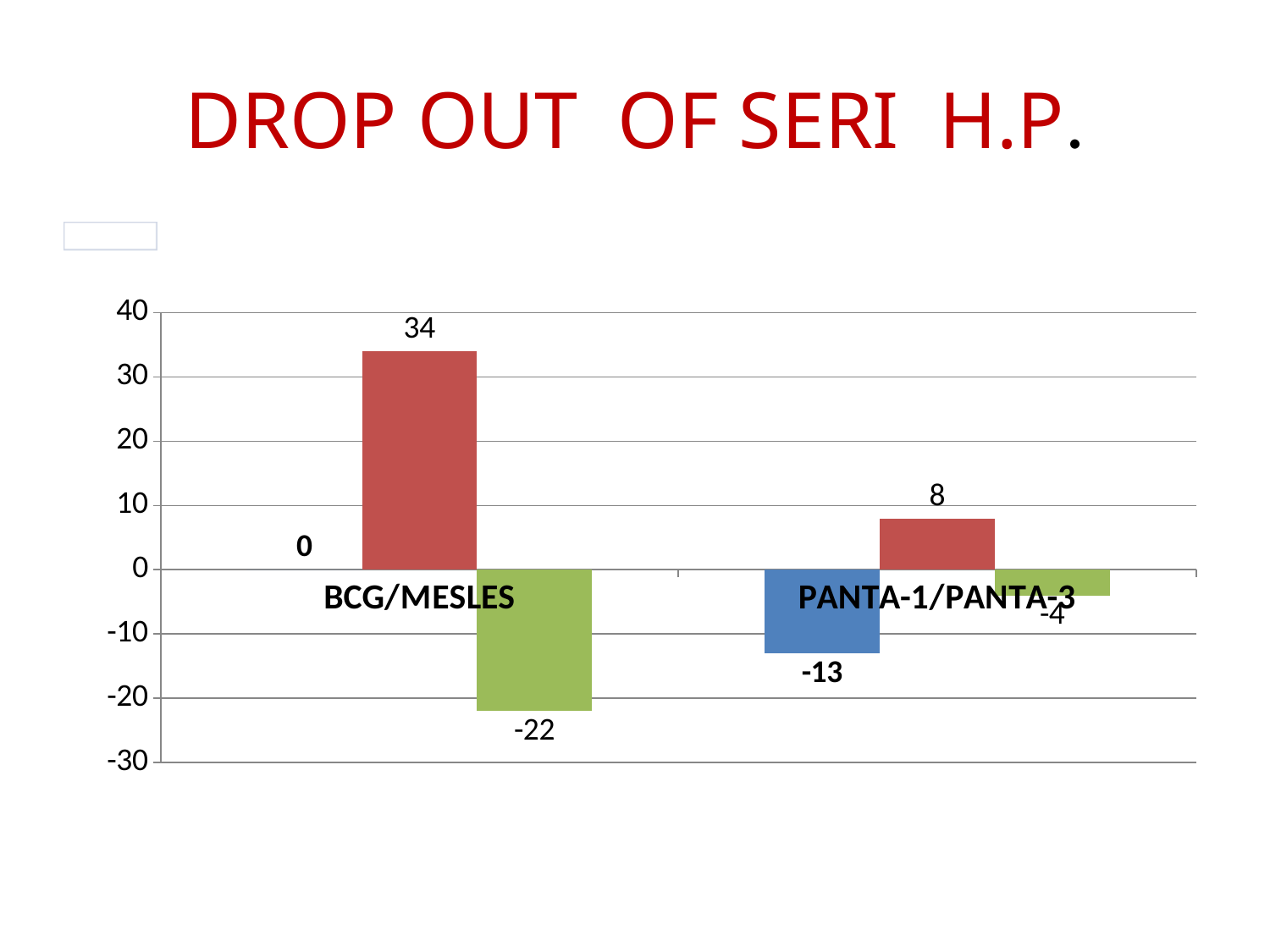
How many categories are shown on the x axis? 2 What is the difference between the red bar values for BCG/MESLES and PANTA-1/PANTA-3? 26 What type of chart is shown on the slide? Bar chart What is the value of the red bar for BCG/MESLES? 34 What is the value of the green bar for PANTA-1/PANTA-3? -4 What is the value of the red bar for PANTA-1/PANTA-3? 8 What is the value of the green bar for BCG/MESLES? -22 What is the value of the blue bar for BCG/MESLES? 0 Which category has the highest red bar value? BCG/MESLES Which category has the lowest green bar value? BCG/MESLES Which is larger, the blue bar value for BCG/MESLES or the blue bar value for PANTA-1/PANTA-3? BCG/MESLES What is the value of the blue bar for PANTA-1/PANTA-3? -13